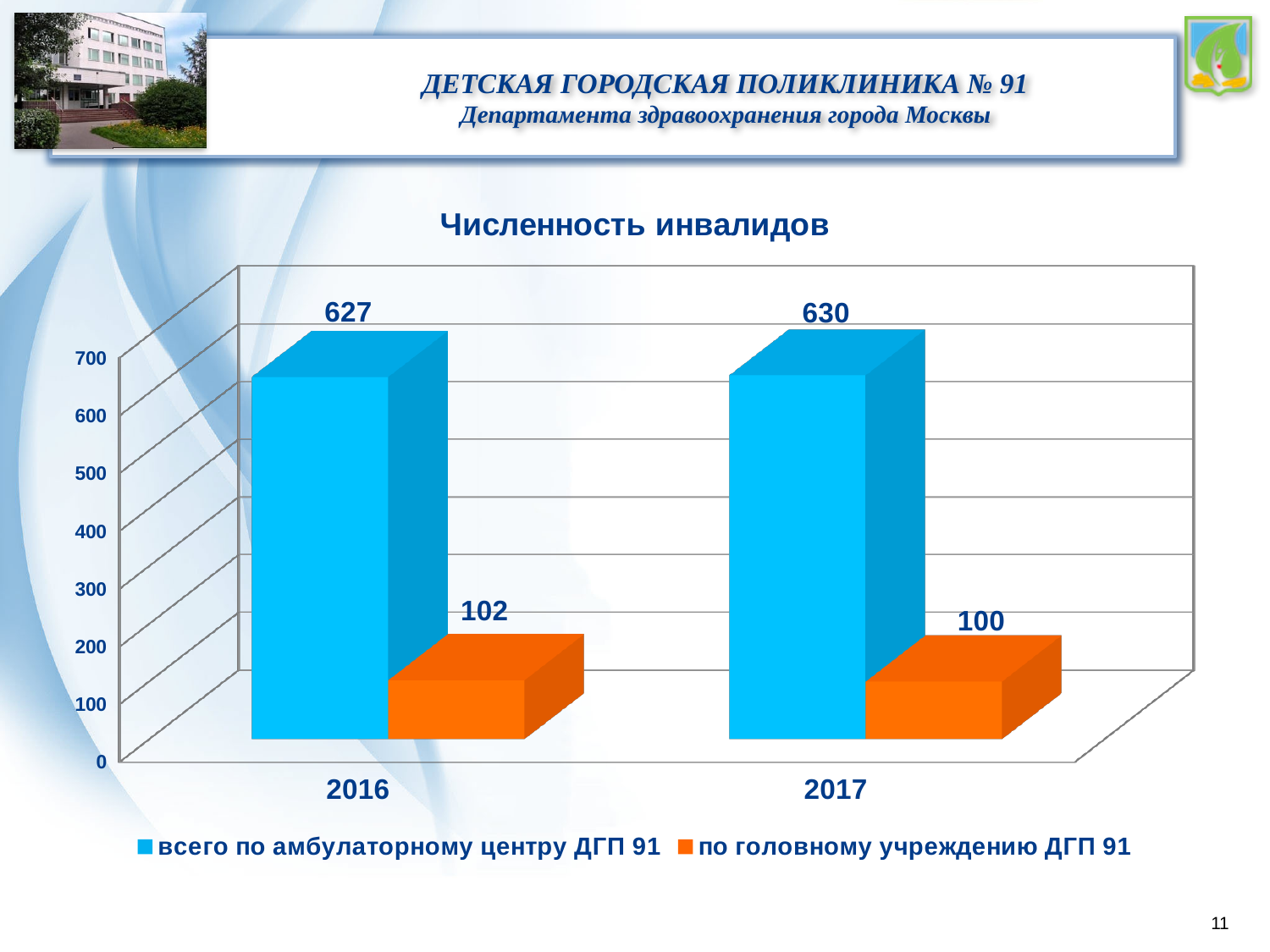
Is the value for "всего по амбулаторному центру ДГП 91" in 2017 greater or less than 600? greater What is the difference between the "всего по амбулаторному центру ДГП 91" values for 2017 and 2016? 3 Which year has the higher value for "по головному учреждению ДГП 91"? 2016 What is the title of the chart? Численность инвалидов What is the value for "по головному учреждению ДГП 91" in 2017? 100 How many years are shown on the x axis? 2 What is the value for "всего по амбулаторному центру ДГП 91" in 2017? 630 What kind of chart is shown on the slide? bar chart What is the difference between the two series values in 2016? 525 What is the value for "всего по амбулаторному центру ДГП 91" in 2016? 627 How many series does the legend list? 2 What is the value for "по головному учреждению ДГП 91" in 2016? 102